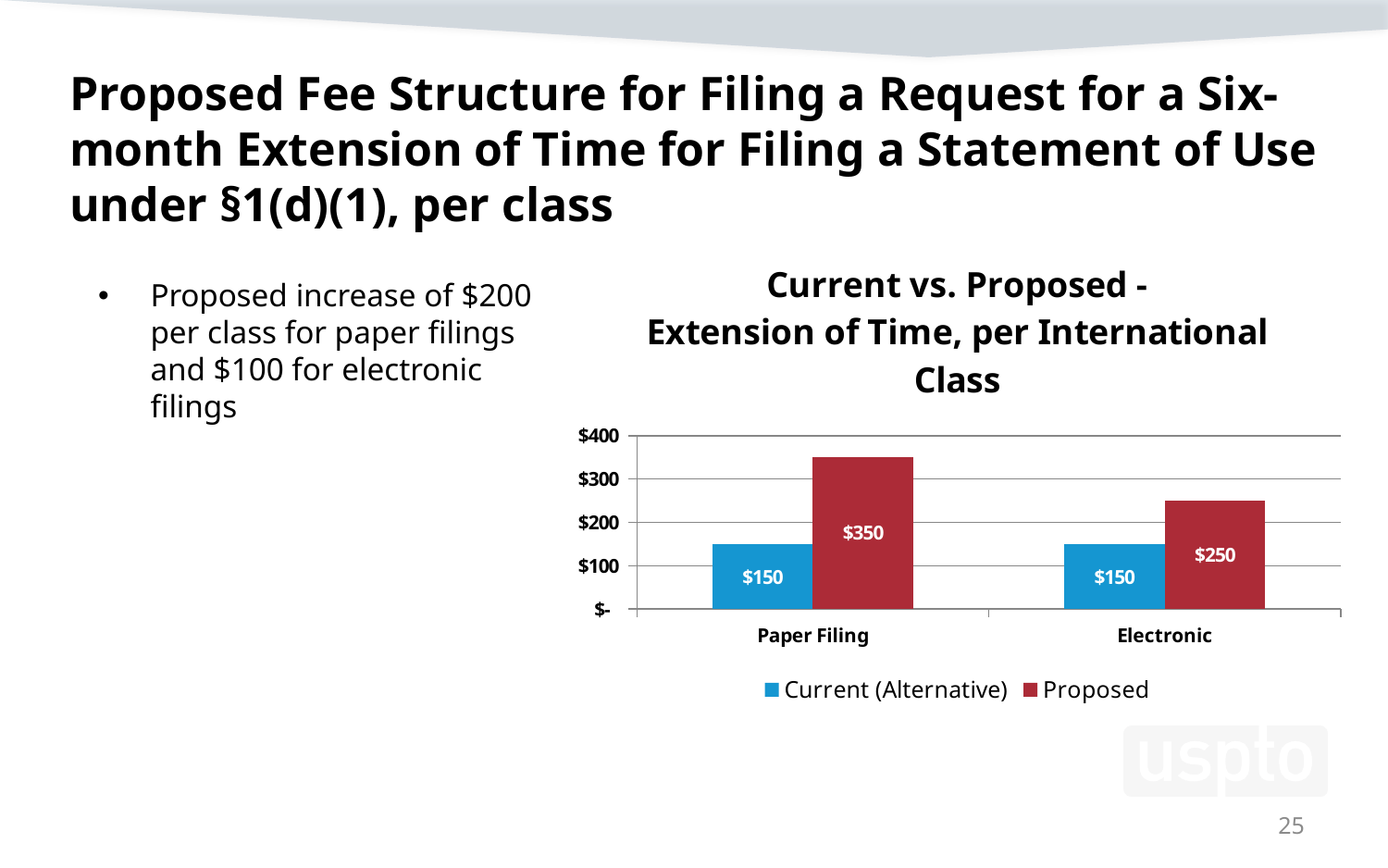
How many categories are shown on the x axis of the chart? 2 Which is larger, the Proposed fee for Paper Filing or the Proposed fee for Electronic filing? Proposed fee for Paper Filing What kind of chart is shown on the slide? Bar chart Is the Proposed fee for Paper Filing greater or less than $300? greater What is the difference between the Proposed and Current (Alternative) fees for Paper Filing? $200 What is the Current (Alternative) fee for Electronic filing? $150 What is the Proposed fee for Electronic filing? $250 What is the Proposed fee for Paper Filing? $350 What is the difference between the Proposed and Current (Alternative) fees for Electronic filing? $100 Which category has the highest Proposed fee? Paper Filing How many series does the chart legend list? 2 What is the title of the chart? Current vs. Proposed - Extension of Time, per International Class